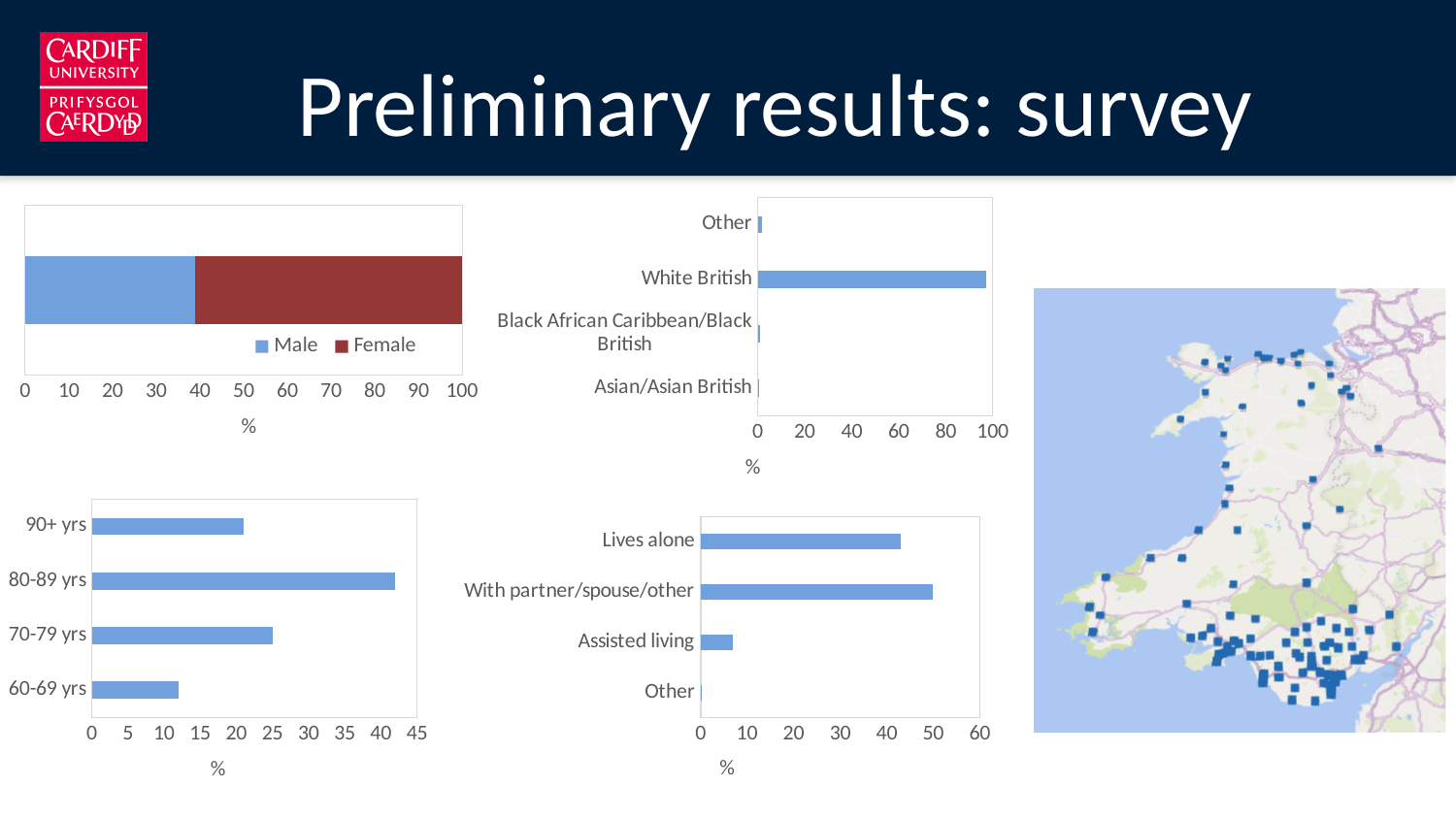
In the age group chart (bottom left), is the value for 60-69 yrs greater or less than 15? less In the top-left chart with the Male and Female legend, how many series does the legend list? 2 In the ethnicity chart (top middle), which category has the highest value? White British In the living arrangement chart (bottom middle), is the value for Assisted living greater or less than 10? less In the ethnicity chart (top middle), is the value for White British greater or less than 80? greater In the age group chart (bottom left), which age group has the lowest value? 60-69 yrs In the top-left chart with the Male and Female legend, which series is larger, Male or Female? Female In the age group chart (bottom left), which age group has the highest value? 80-89 yrs In the living arrangement chart (bottom middle), which category has the highest value? With partner/spouse/other In the ethnicity chart (top middle), how many categories are shown? 4 What kind of chart is the living arrangement chart (bottom middle)? bar chart